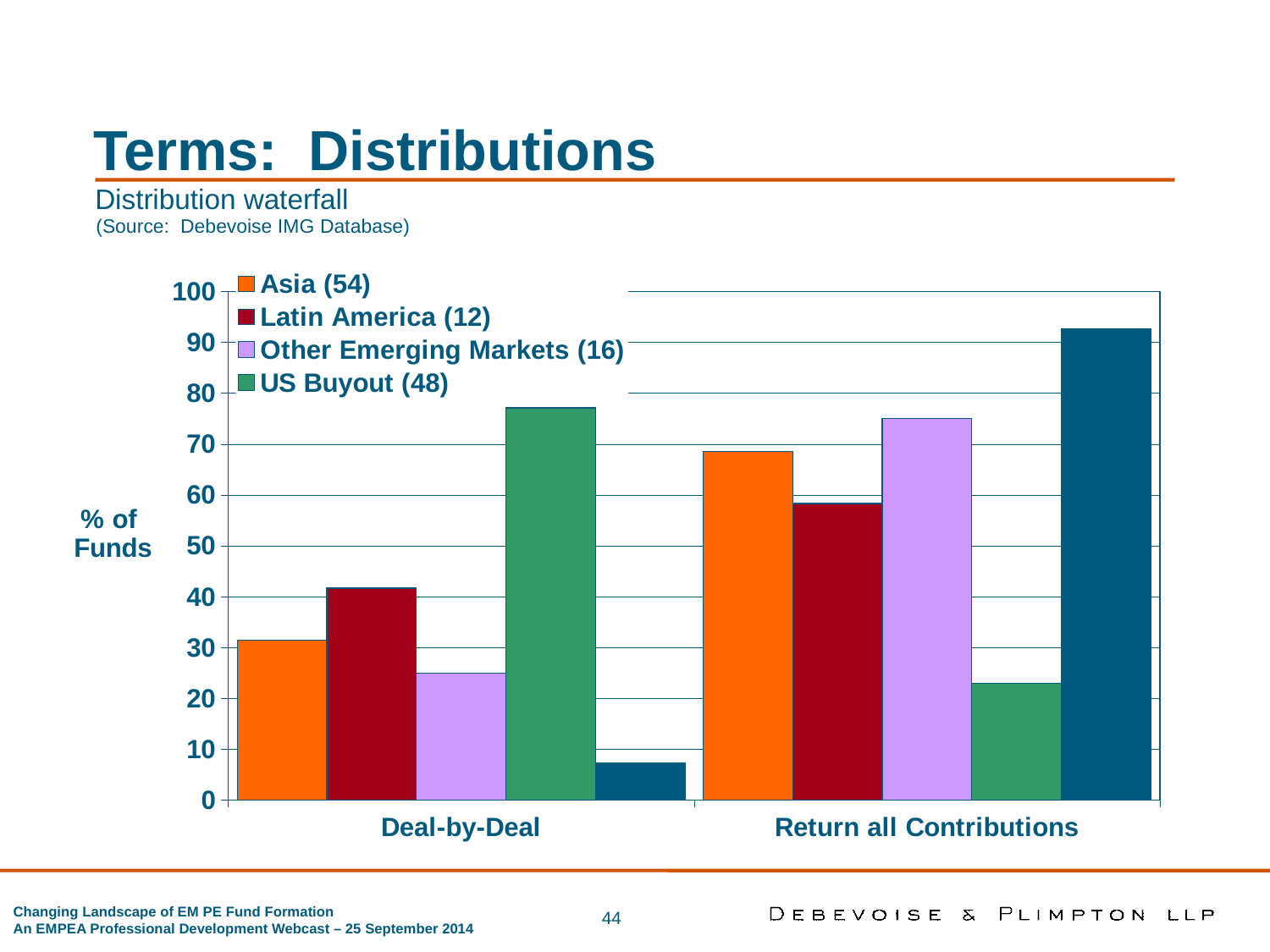
What kind of chart is shown on the slide? Bar chart Among the series listed in the legend, which has the lowest bar under Deal-by-Deal? Other Emerging Markets (16) Is the value for US Buyout (48) under Deal-by-Deal greater or less than 70? greater Among the series listed in the legend, which has the highest bar under Deal-by-Deal? US Buyout (48) What is the label on the chart's vertical axis? % of Funds Is the value for Other Emerging Markets (16) under Return all Contributions greater or less than 70? greater How many series does the chart's legend list? 4 Is the value for US Buyout (48) under Return all Contributions greater or less than 30? less Under Deal-by-Deal, which is larger: Asia (54) or Latin America (12)? Latin America (12) Under Return all Contributions, which is larger: Asia (54) or Latin America (12)? Asia (54) How many categories are shown on the x axis of the chart? 2